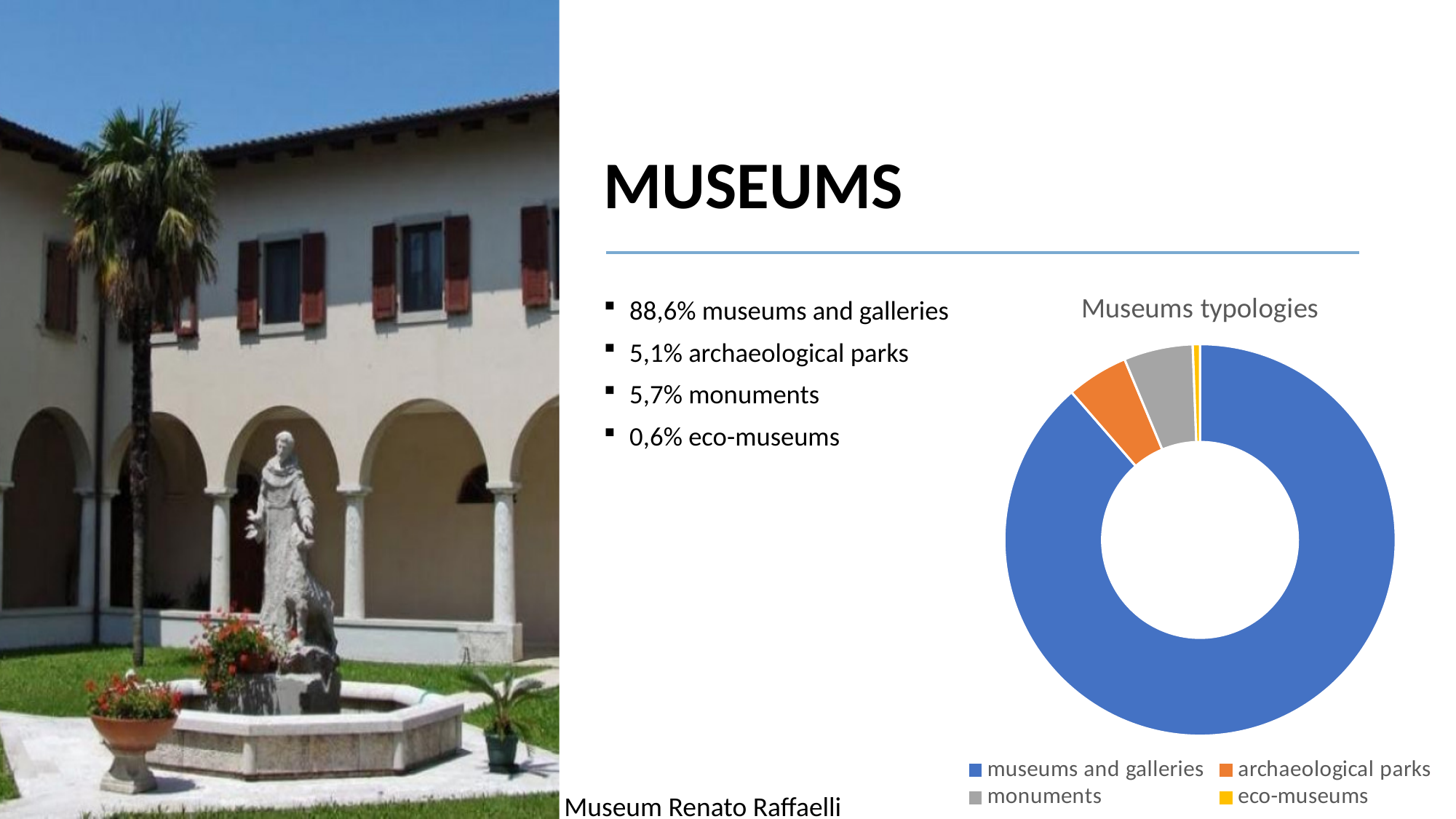
What is the value for monuments in the "Museums typologies" chart? 5,7% How many categories does the "Museums typologies" chart show? 4 How many entries does the legend of the "Museums typologies" chart list? 4 Which category has the largest slice in the "Museums typologies" chart? museums and galleries Which category has the smallest slice in the "Museums typologies" chart? eco-museums What is the value for eco-museums in the "Museums typologies" chart? 0,6% What kind of chart is the "Museums typologies" chart? Doughnut (pie) chart In the "Museums typologies" chart, which is larger: monuments or archaeological parks? monuments What is the title of the chart on the slide? Museums typologies What is the value for archaeological parks in the "Museums typologies" chart? 5,1% What is the difference between the shares of museums and galleries and monuments in the "Museums typologies" chart? 82,9% What share of the "Museums typologies" chart is museums and galleries? 88,6%